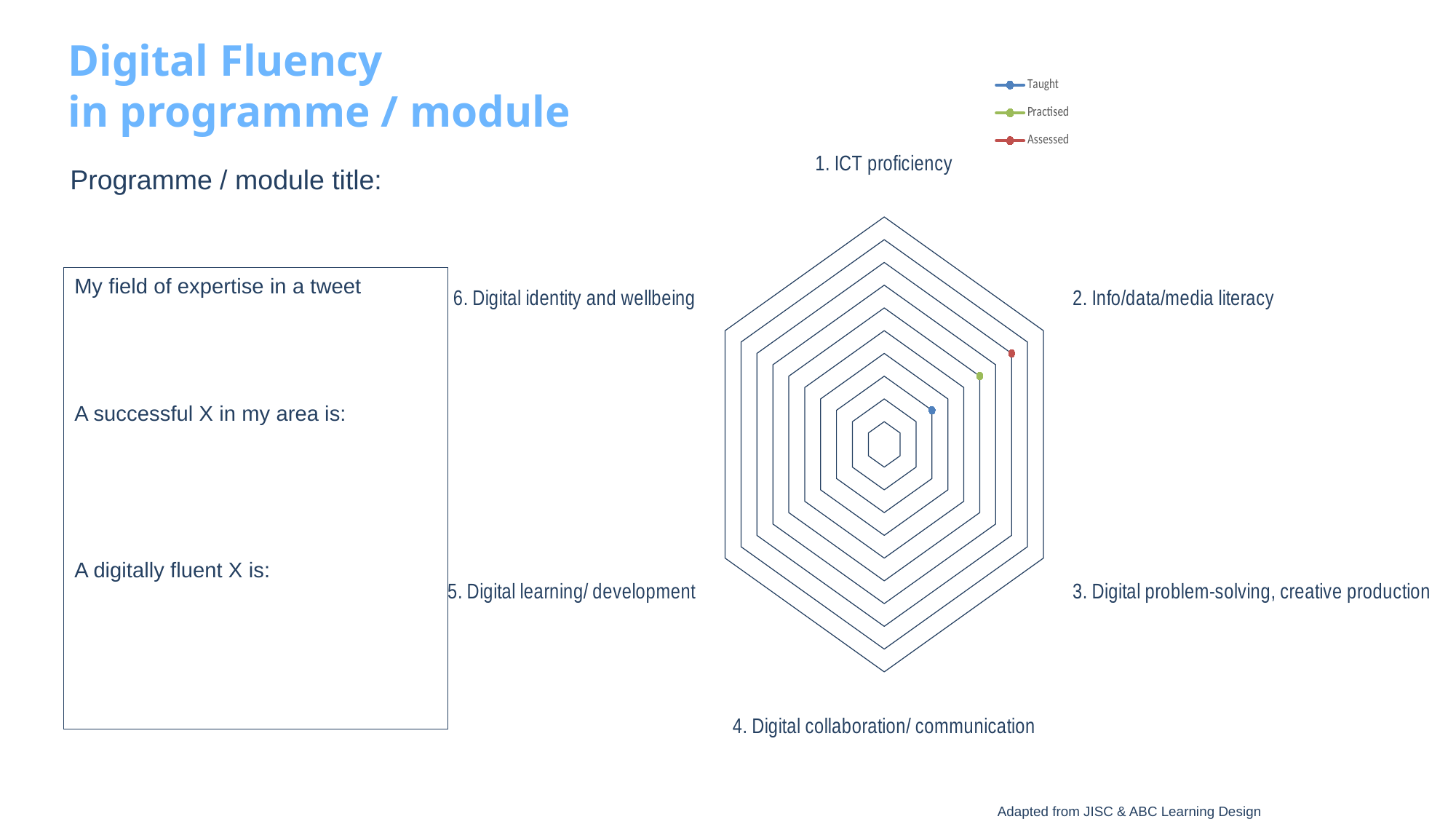
How many series does the chart legend list? 3 On the '2. Info/data/media literacy' axis, which is larger: the Practised value or the Taught value? Practised On which category axis are the data points plotted? 2. Info/data/media literacy Which series has the lowest value on the '2. Info/data/media literacy' axis? Taught Which series has the highest value on the '2. Info/data/media literacy' axis? Assessed What kind of chart is shown on the slide? Radar chart On the '2. Info/data/media literacy' axis, which is larger: the Assessed value or the Taught value? Assessed Which category label appears at the top of the radar chart? 1. ICT proficiency What are the three series named in the legend? Taught, Practised, Assessed How many categories (axes) does the radar chart have? 6 Which category label appears at the bottom of the radar chart? 4. Digital collaboration/ communication